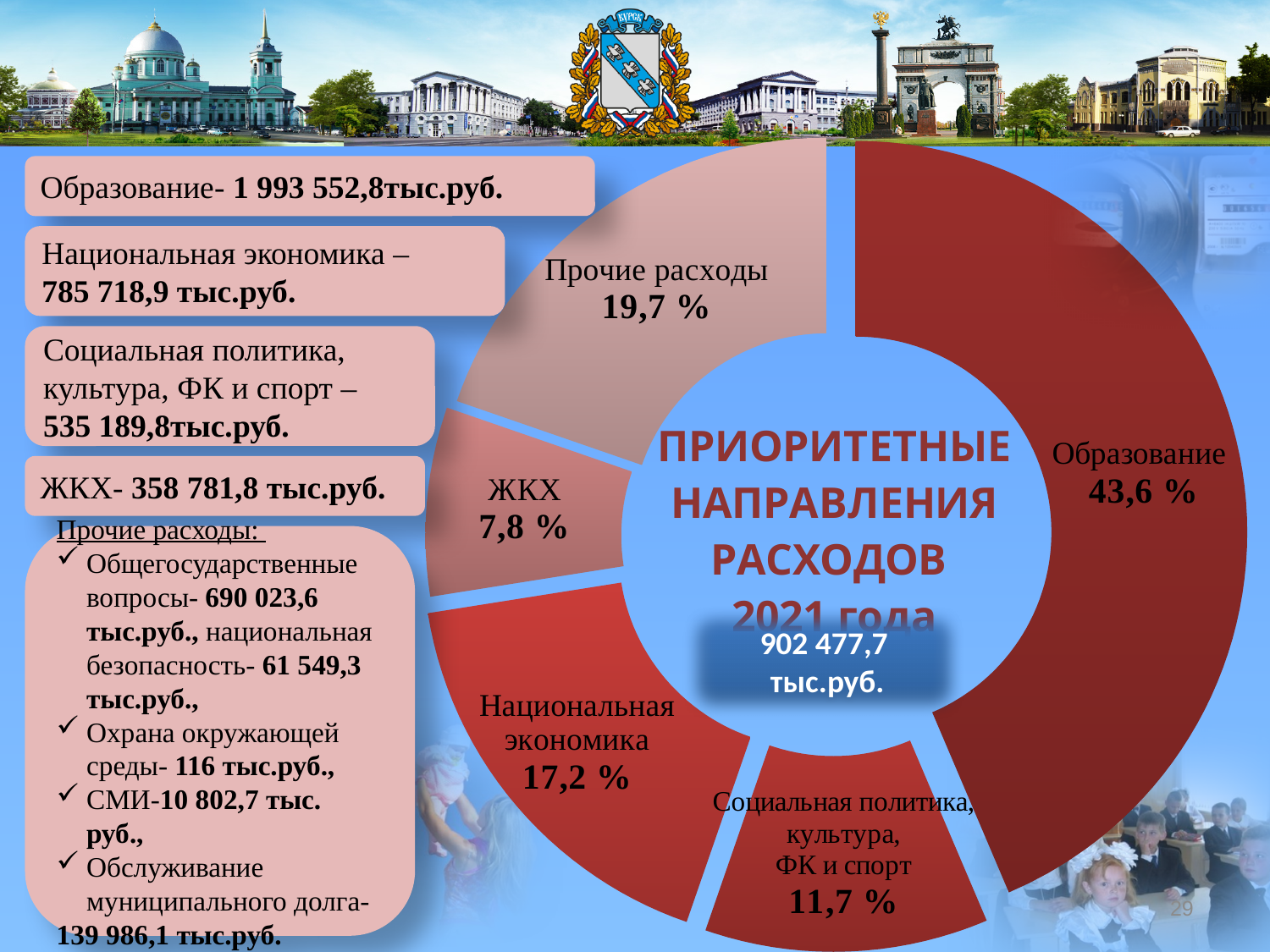
Which category has the largest share in the chart? Образование What share of the doughnut chart does Образование account for? 43,6 % What type of chart is shown on the slide? Doughnut (pie) chart How many segments does the chart have? 5 What is the title shown in the centre of the chart? ПРИОРИТЕТНЫЕ НАПРАВЛЕНИЯ РАСХОДОВ 2021 года Which category has the smallest share in the chart? ЖКХ By how many percentage points does Образование exceed Прочие расходы? 23,9 What percentage is shown for Прочие расходы in the chart? 19,7 % What percentage is shown for ЖКХ in the chart? 7,8 % What percentage is shown for Национальная экономика in the chart? 17,2 % What percentage is shown for Социальная политика, культура, ФК и спорт in the chart? 11,7 % Which is larger: the share of Национальная экономика or the share of Социальная политика, культура, ФК и спорт? Национальная экономика